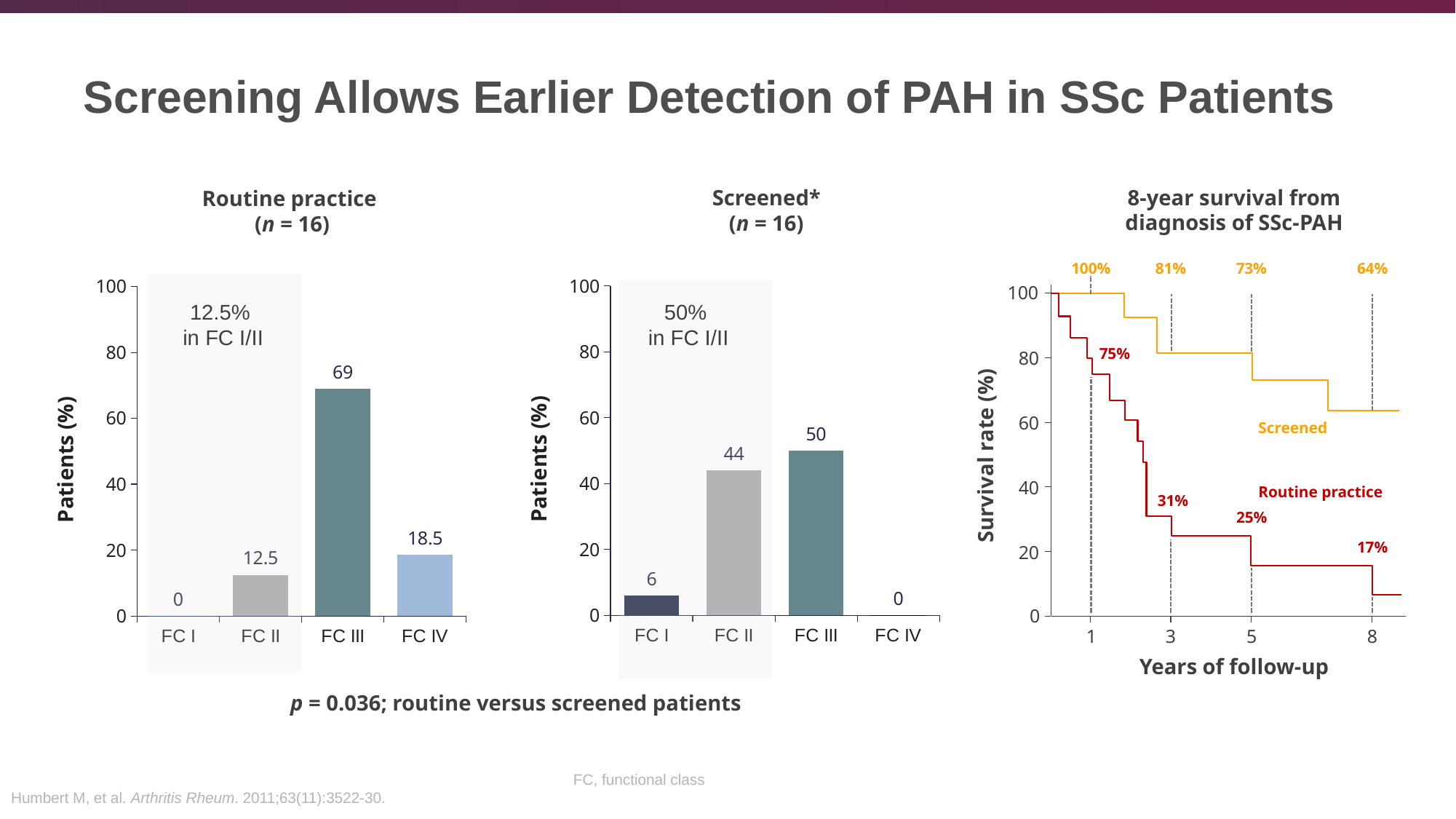
In the Routine practice chart, what is the value for FC III? 69 In the 8-year survival chart, what is the difference between the Screened and Routine practice survival rates at 5 years? 48% In the Screened chart, which functional class has the highest percentage of patients? FC III In the Screened chart, what is the value for FC II? 44 In the Routine practice chart, what is the value for FC IV? 18.5 What kind of chart is the Screened chart? bar chart How many functional class categories are shown on the x axis of the Routine practice chart? 4 In the 8-year survival chart, what is the survival rate for the Screened group at 8 years? 64% In the Routine practice chart, which functional class has the lowest percentage of patients? FC I In the Screened chart, what is the difference between the values for FC III and FC II? 6 In the Routine practice chart, is the value for FC II larger or smaller than the value for FC IV? smaller In the 8-year survival chart, does the Routine practice survival rate rise or fall over the years of follow-up? fall